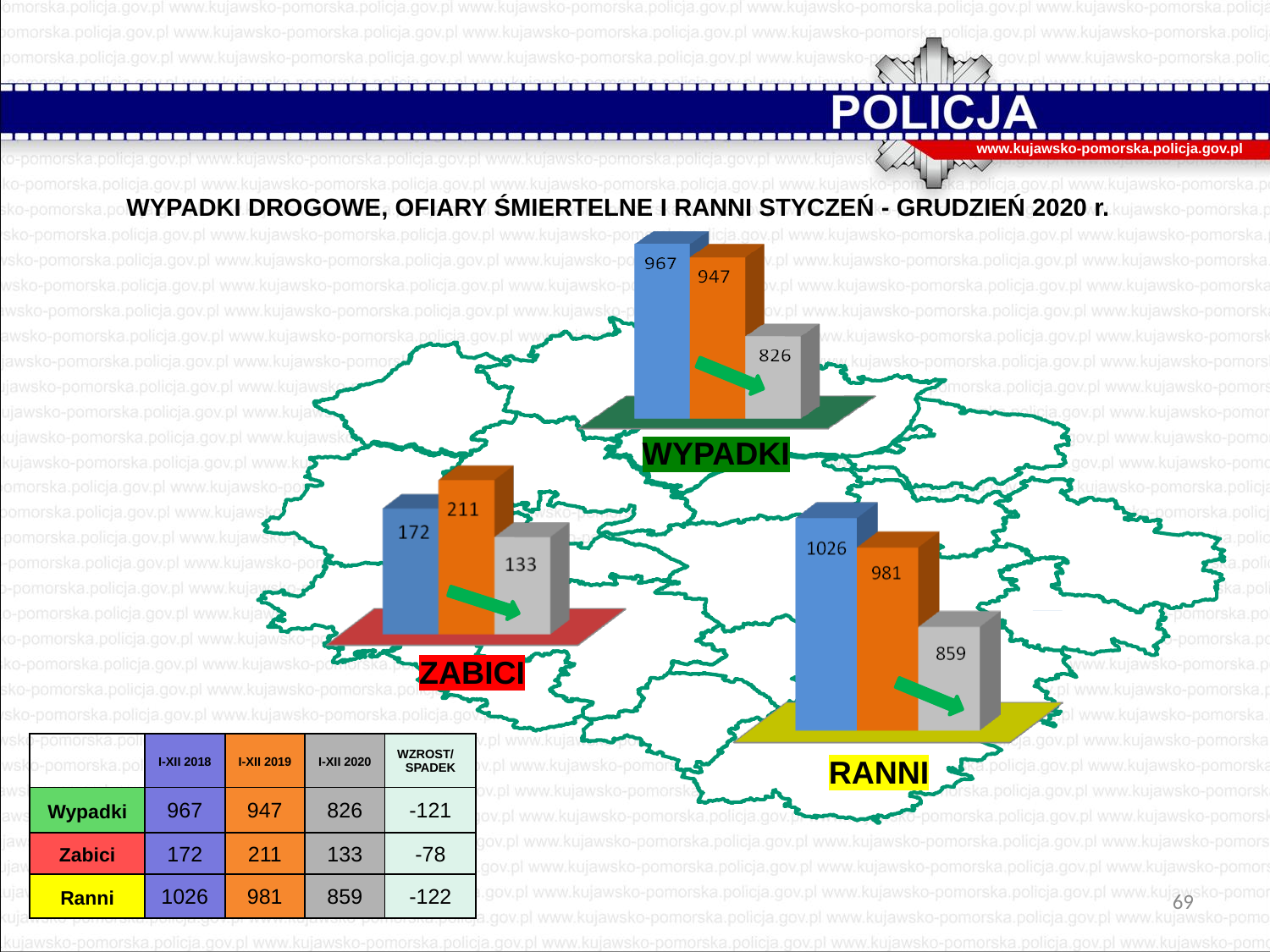
In the WYPADKI chart, which bar is the lowest? 826 (I-XII 2020) In the WYPADKI chart, what is the value of the grey bar for I-XII 2020? 826 In the ZABICI chart, which bar is the highest? 211 (I-XII 2019) In the WYPADKI chart, which is larger: the blue bar or the orange bar? the blue bar (967) In the RANNI chart, what is the value of the grey bar for I-XII 2020? 859 In the WYPADKI chart, what is the value of the first (blue) bar? 967 In the RANNI chart, what is the difference between the blue bar (1026) and the grey bar (859)? 167 In the ZABICI chart, what is the value of the orange bar for I-XII 2019? 211 What kind of chart is the ZABICI chart? bar chart In the ZABICI chart, what is the difference between the orange bar (211) and the grey bar (133)? 78 How many bars does the RANNI chart have? 3 In the RANNI chart, what is the value of the first (blue) bar? 1026